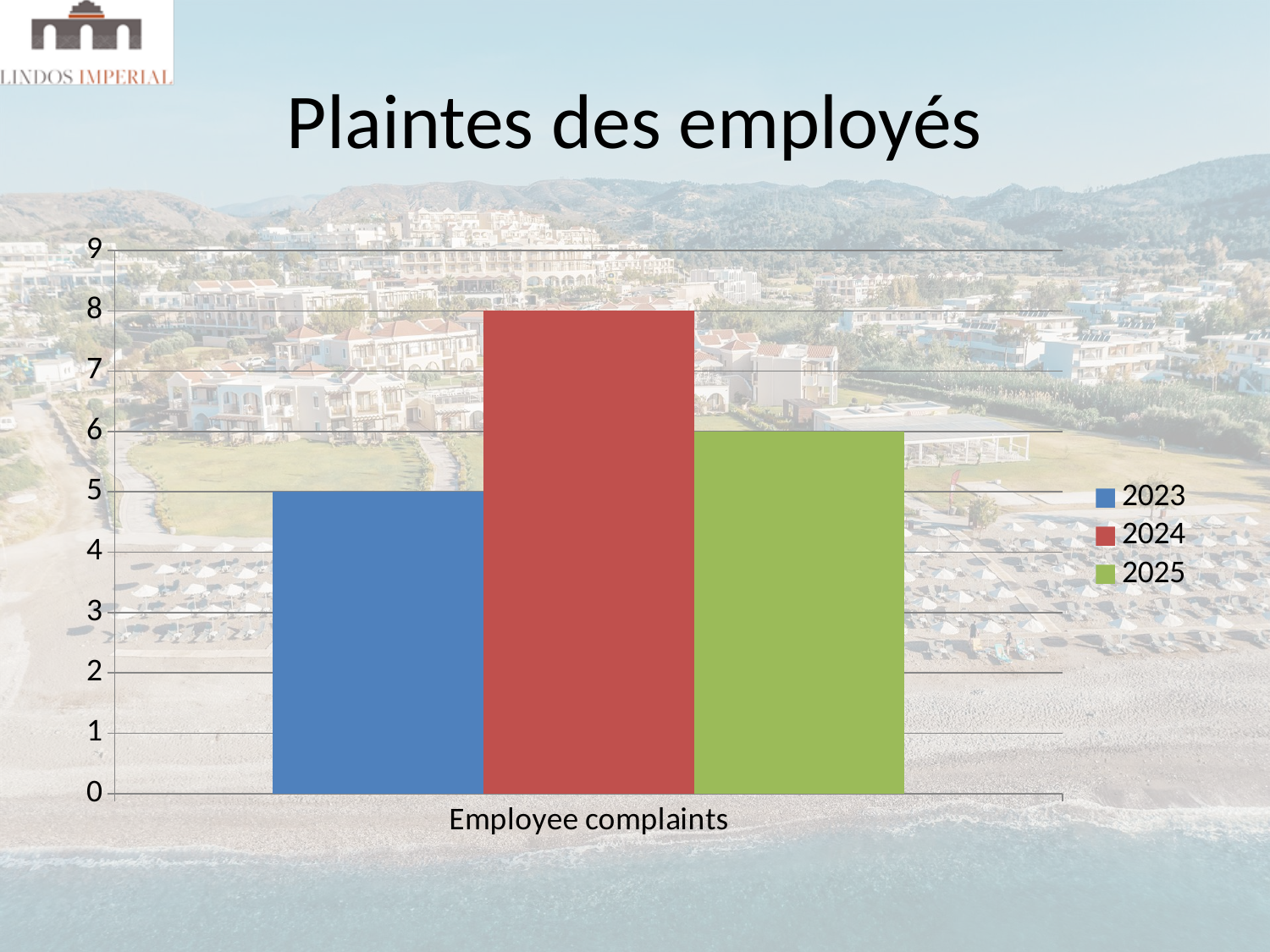
What is the title of the slide containing the chart? Plaintes des employés What is the difference between the 2024 and 2025 values? 2 Is the value for 2024 greater or less than 7? greater Which is larger, the value for 2025 or the value for 2023? 2025 What is the value for 2023 in the Employee complaints chart? 5 What is the value for 2025 in the Employee complaints chart? 6 What type of chart is shown on the slide? bar chart What is the value for 2024 in the Employee complaints chart? 8 Which year has the highest number of employee complaints? 2024 How many series does the legend list? 3 What is the difference between the 2024 and 2023 values? 3 Which year has the lowest number of employee complaints? 2023